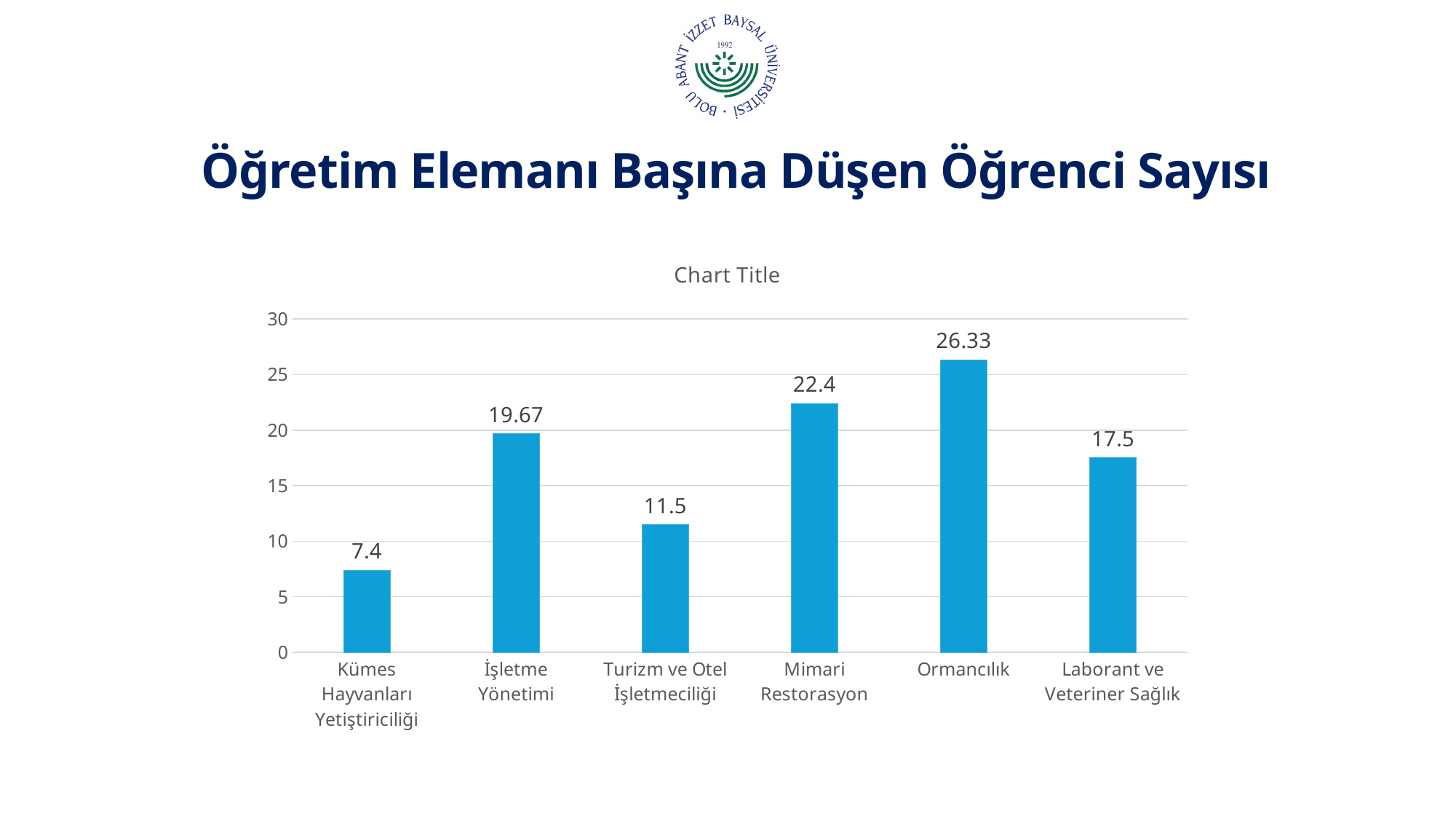
How many categories are shown on the chart? 6 Is the value for Mimari Restorasyon greater or less than 20? greater What is the value for Turizm ve Otel İşletmeciliği? 11.5 What kind of chart is shown on the slide? bar chart What is the title shown above the chart? Chart Title What is the value for Kümes Hayvanları Yetiştiriciliği? 7.4 What is the difference between the values for Ormancılık and Mimari Restorasyon? 3.93 What is the value for Laborant ve Veteriner Sağlık? 17.5 What is the value for Ormancılık? 26.33 Which category has the lowest value? Kümes Hayvanları Yetiştiriciliği Which category has the highest value? Ormancılık Which is larger, the value for İşletme Yönetimi or the value for Laborant ve Veteriner Sağlık? İşletme Yönetimi